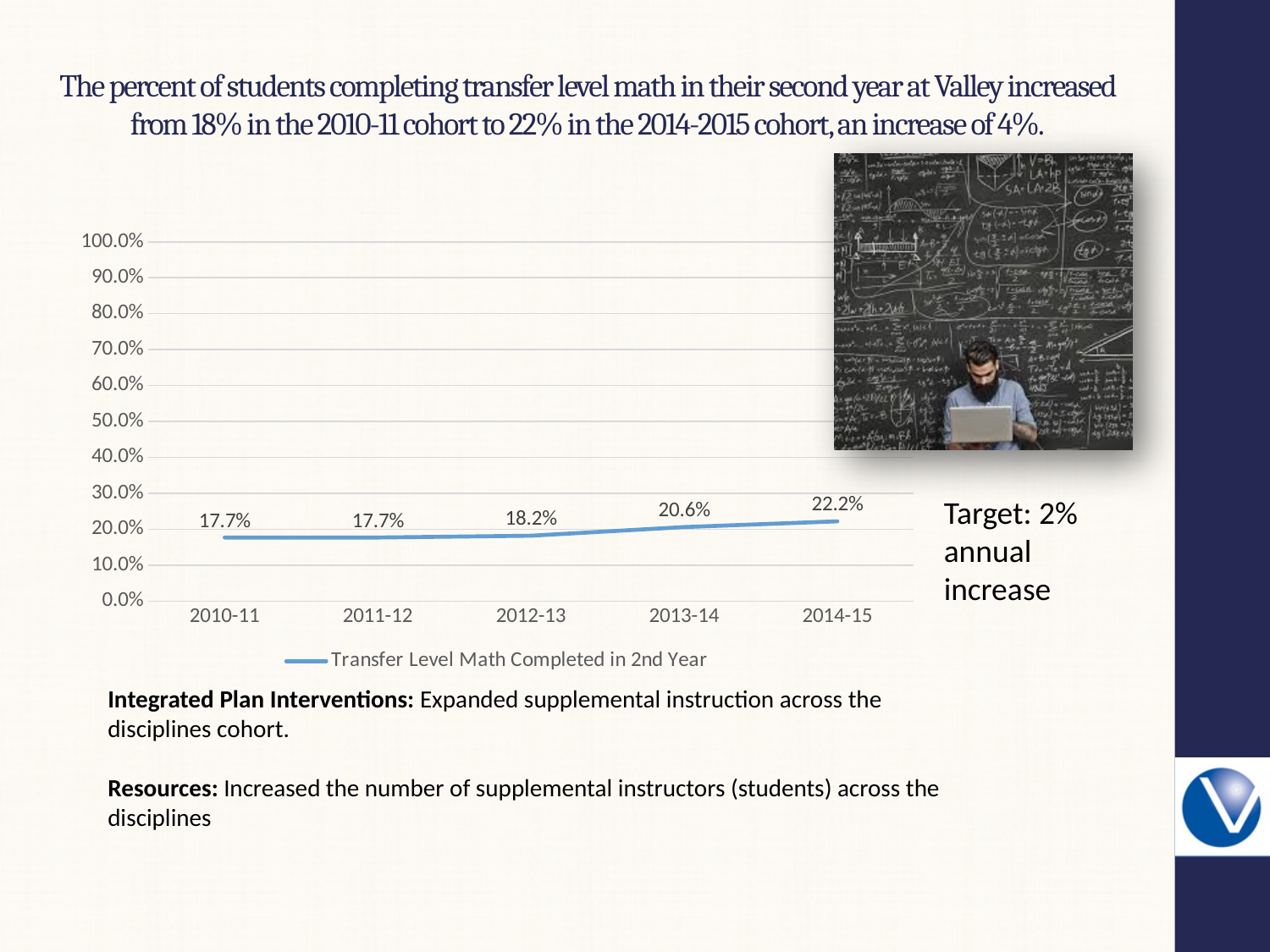
What is the difference between the values for 2014-15 and 2010-11? 4.5% How many cohort years are plotted on the x axis? 5 Which is larger, the value for 2013-14 or the value for 2012-13? 2013-14 What is the value for 2013-14? 20.6% Do the values rise or fall from 2010-11 to 2014-15? rise Which cohort year has the highest value? 2014-15 What is the value for 2012-13? 18.2% What kind of chart is shown? line chart What is the value for 2014-15? 22.2% What is the value for 2010-11? 17.7% Is the value for 2014-15 greater or less than 30.0%? less What is the difference between the values for 2013-14 and 2012-13? 2.4%